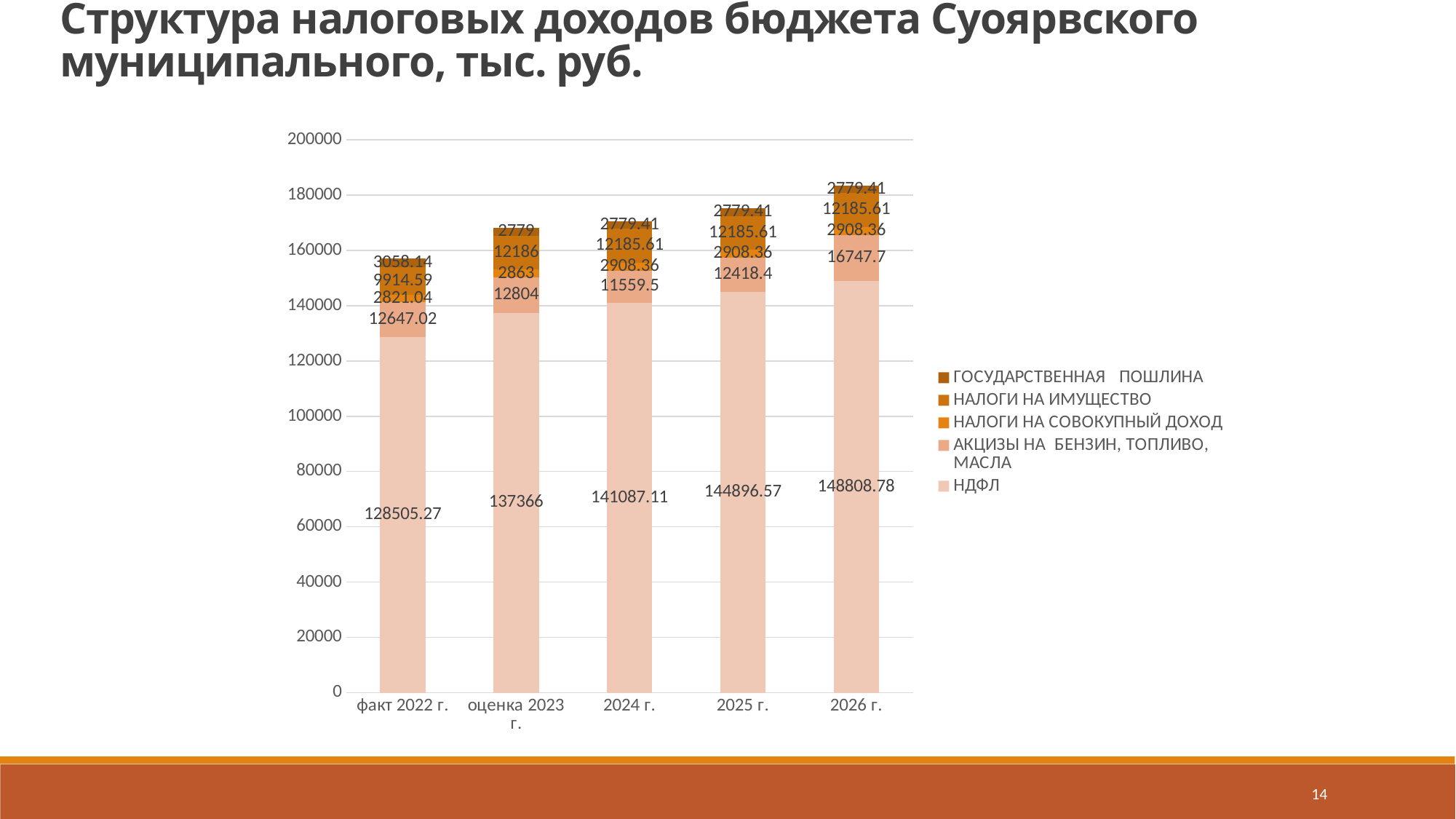
What type of chart is shown on the slide? stacked bar chart How many series does the legend list? 5 Does НДФЛ rise or fall from факт 2022 г. to 2026 г.? rise What is the value of НДФЛ for факт 2022 г.? 128505.27 What is the value of НДФЛ for 2026 г.? 148808.78 In which category is НДФЛ the highest? 2026 г. What is the value of АКЦИЗЫ НА БЕНЗИН, ТОПЛИВО, МАСЛА for 2026 г.? 16747.7 How many categories are shown on the x axis? 5 What is the total of the stacked bar for оценка 2023 г.? 167998 What is the value of НАЛОГИ НА ИМУЩЕСТВО for оценка 2023 г.? 12186 In which category is НДФЛ the lowest? факт 2022 г. What is the difference between НДФЛ in 2026 г. and НДФЛ in факт 2022 г.? 20303.51